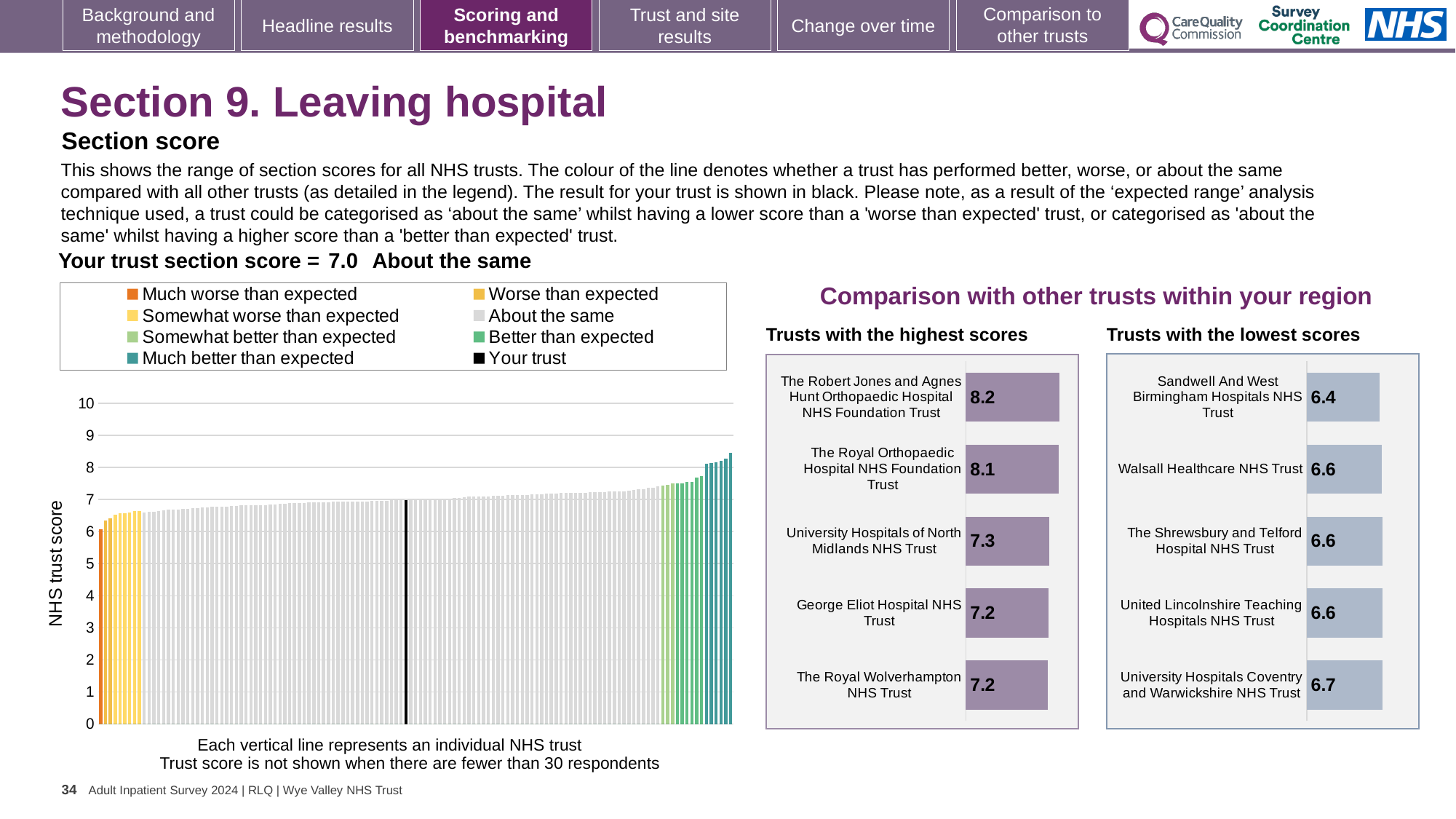
In the 'Trusts with the lowest scores' chart, which is larger: the score for Walsall Healthcare NHS Trust or the score for Sandwell And West Birmingham Hospitals NHS Trust? Walsall Healthcare NHS Trust In the large 'NHS trust score' chart on the left, is the value of the tallest bar greater or less than 8? greater In the 'Trusts with the highest scores' chart, what is the difference between the scores of The Royal Orthopaedic Hospital NHS Foundation Trust and George Eliot Hospital NHS Trust? 0.9 What type of chart is the large 'NHS trust score' chart on the left? Bar chart In the large 'NHS trust score' chart on the left, how many entries does the legend list? 8 In the 'Trusts with the lowest scores' chart, how many trusts are shown? 5 In the 'Trusts with the lowest scores' chart, what is the score for University Hospitals Coventry and Warwickshire NHS Trust? 6.7 In the 'Trusts with the lowest scores' chart, which trust has the lowest score? Sandwell And West Birmingham Hospitals NHS Trust In the 'Trusts with the highest scores' chart, what is the score for University Hospitals of North Midlands NHS Trust? 7.3 In the 'Trusts with the highest scores' chart, which trust has the highest score? The Robert Jones and Agnes Hunt Orthopaedic Hospital NHS Foundation Trust In the 'Trusts with the highest scores' chart, what is the score for The Robert Jones and Agnes Hunt Orthopaedic Hospital NHS Foundation Trust? 8.2 In the 'Trusts with the highest scores' chart, what is the difference between the scores of The Robert Jones and Agnes Hunt Orthopaedic Hospital NHS Foundation Trust and The Royal Wolverhampton NHS Trust? 1.0